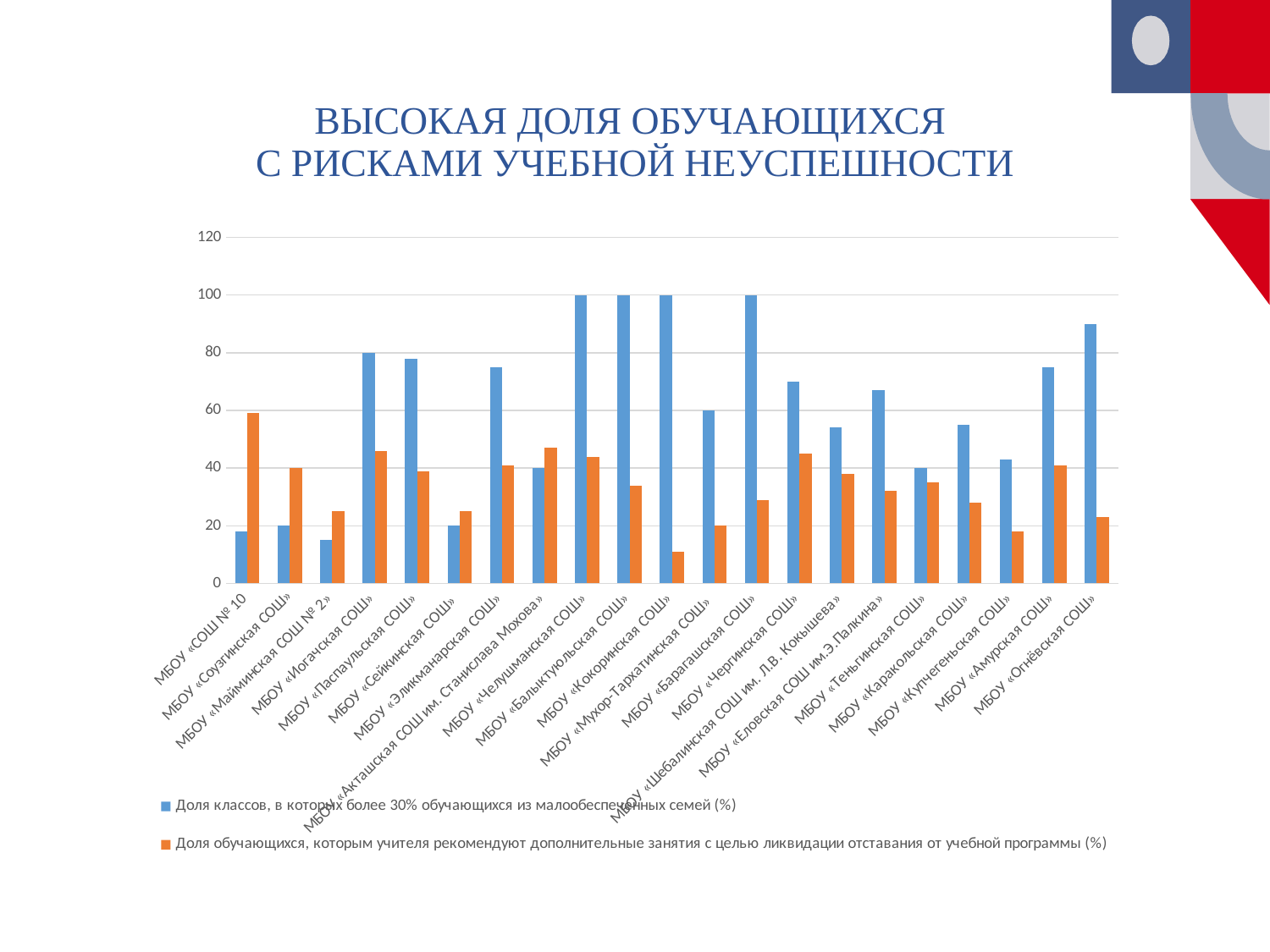
Which school has the lowest value for 'Доля обучающихся, которым учителя рекомендуют дополнительные занятия с целью ликвидации отставания от учебной программы (%)'? МБОУ «Кокоринская СОШ» For МБОУ «СОШ № 10», which series has the larger value: the blue series or the orange series? the orange series (Доля обучающихся, которым учителя рекомендуют дополнительные занятия) How many series does the legend list? 2 Is the value of 'Доля обучающихся, которым учителя рекомендуют дополнительные занятия с целью ликвидации отставания от учебной программы (%)' for МБОУ «Кокоринская СОШ» greater or less than 20? less What is the value of 'Доля классов, в которых более 30% обучающихся из малообеспеченных семей (%)' for МБОУ «Мухор-Тархатинская СОШ»? 60 Which school has the highest value for 'Доля обучающихся, которым учителя рекомендуют дополнительные занятия с целью ликвидации отставания от учебной программы (%)'? МБОУ «СОШ № 10» What is the title of the slide? ВЫСОКАЯ ДОЛЯ ОБУЧАЮЩИХСЯ С РИСКАМИ УЧЕБНОЙ НЕУСПЕШНОСТИ What is the value of 'Доля классов, в которых более 30% обучающихся из малообеспеченных семей (%)' for МБОУ «Иогачская СОШ»? 80 How many schools (categories) are shown on the x axis? 21 What is the value of 'Доля классов, в которых более 30% обучающихся из малообеспеченных семей (%)' for МБОУ «Челушманская СОШ»? 100 Is the value of 'Доля классов, в которых более 30% обучающихся из малообеспеченных семей (%)' for МБОУ «Огнёвская СОШ» greater or less than 80? greater What kind of chart is shown on the slide? bar chart